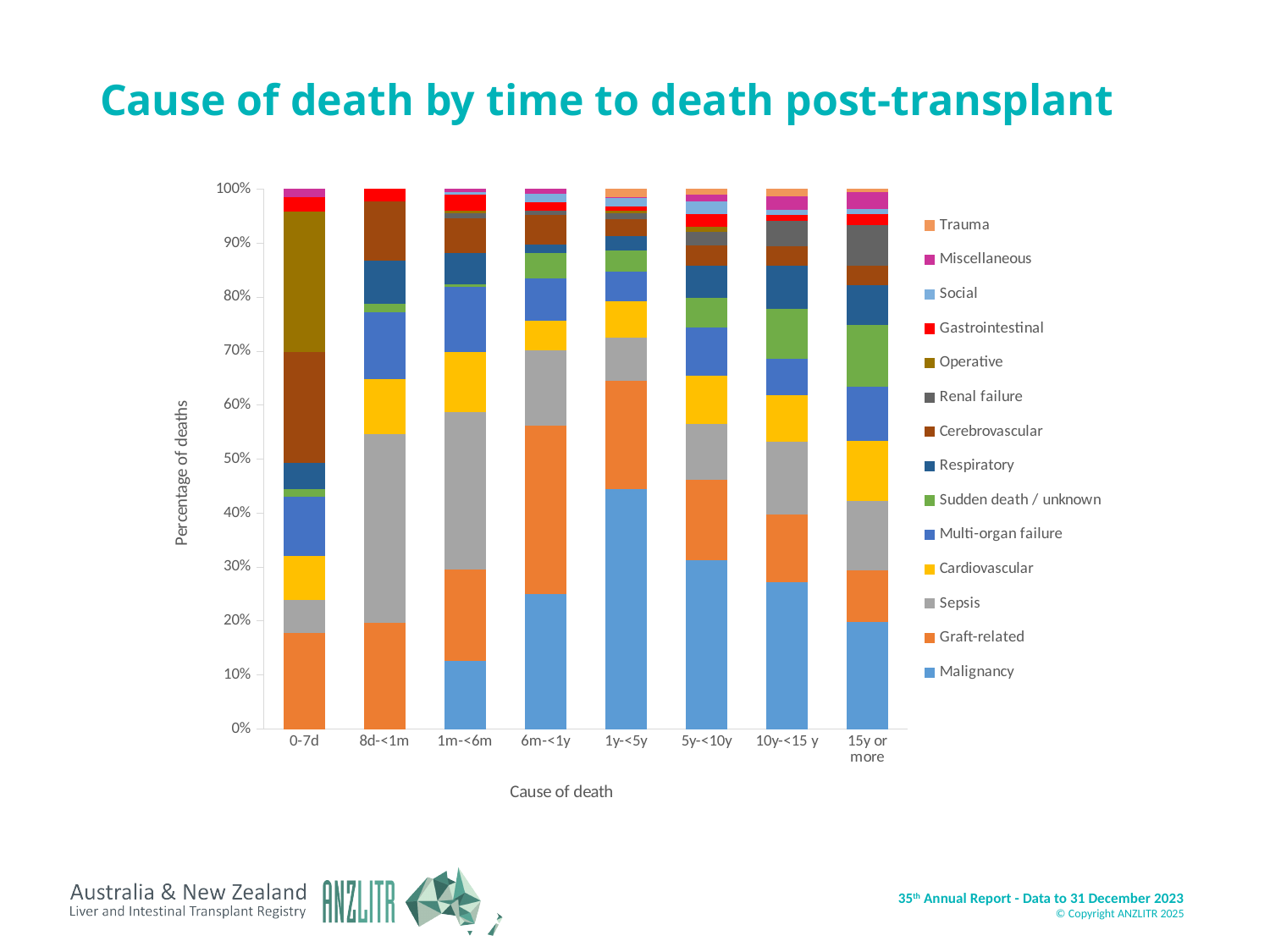
Is the Malignancy share for the 6m-<1y category greater or less than 20%? greater How many causes of death does the legend list? 14 Is the Operative share for the 0-7d category greater or less than 20%? greater What is the title of the chart? Cause of death by time to death post-transplant Which time-to-death category has the largest Malignancy share? 1y-<5y What is the label on the y axis? Percentage of deaths How many time-to-death categories are shown along the x axis? 8 Is the Graft-related share for the 0-7d category greater or less than 20%? less Which has the larger Malignancy share, the 1y-<5y category or the 5y-<10y category? 1y-<5y Which time-to-death category has the largest Operative share? 0-7d What kind of chart is shown on the slide? Stacked bar chart